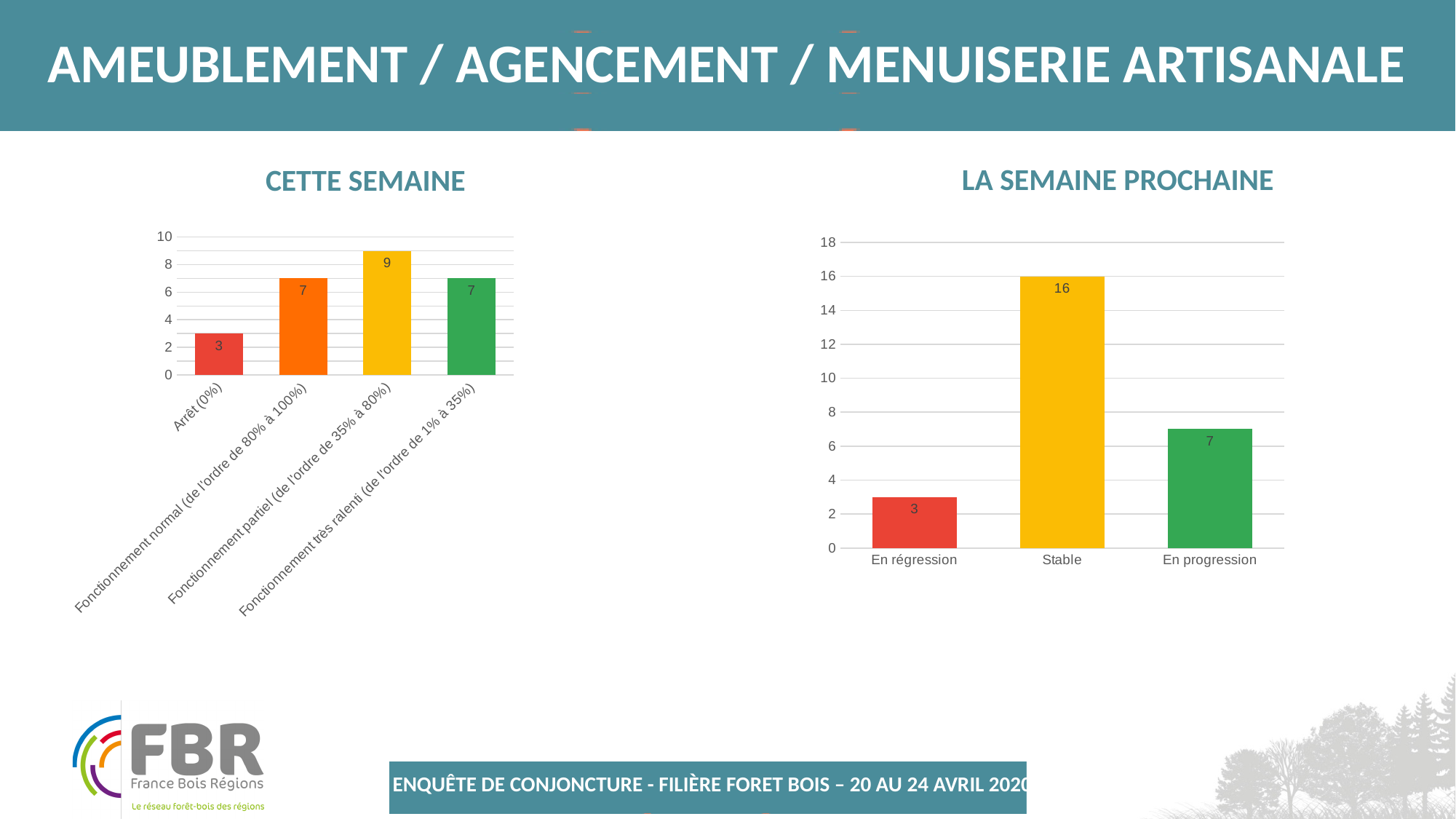
In the 'CETTE SEMAINE' chart, which category has the lowest value? Arrêt (0%) What type of chart is the 'LA SEMAINE PROCHAINE' chart? Bar chart In the 'LA SEMAINE PROCHAINE' chart, which is larger: 'En régression' or 'En progression'? En progression In the 'CETTE SEMAINE' chart, what is the value for 'Arrêt (0%)'? 3 In the 'LA SEMAINE PROCHAINE' chart, which category has the lowest value? En régression In the 'LA SEMAINE PROCHAINE' chart, what is the difference between 'Stable' and 'En progression'? 9 In the 'CETTE SEMAINE' chart, what is the difference between 'Fonctionnement partiel (de l'ordre de 35% à 80%)' and 'Arrêt (0%)'? 6 In the 'LA SEMAINE PROCHAINE' chart, what is the value for 'Stable'? 16 In the 'CETTE SEMAINE' chart, what is the value for 'Fonctionnement partiel (de l'ordre de 35% à 80%)'? 9 In the 'CETTE SEMAINE' chart, which category has the highest value? Fonctionnement partiel (de l'ordre de 35% à 80%) In the 'LA SEMAINE PROCHAINE' chart, what is the value for 'En progression'? 7 In the 'CETTE SEMAINE' chart, how many categories are shown? 4